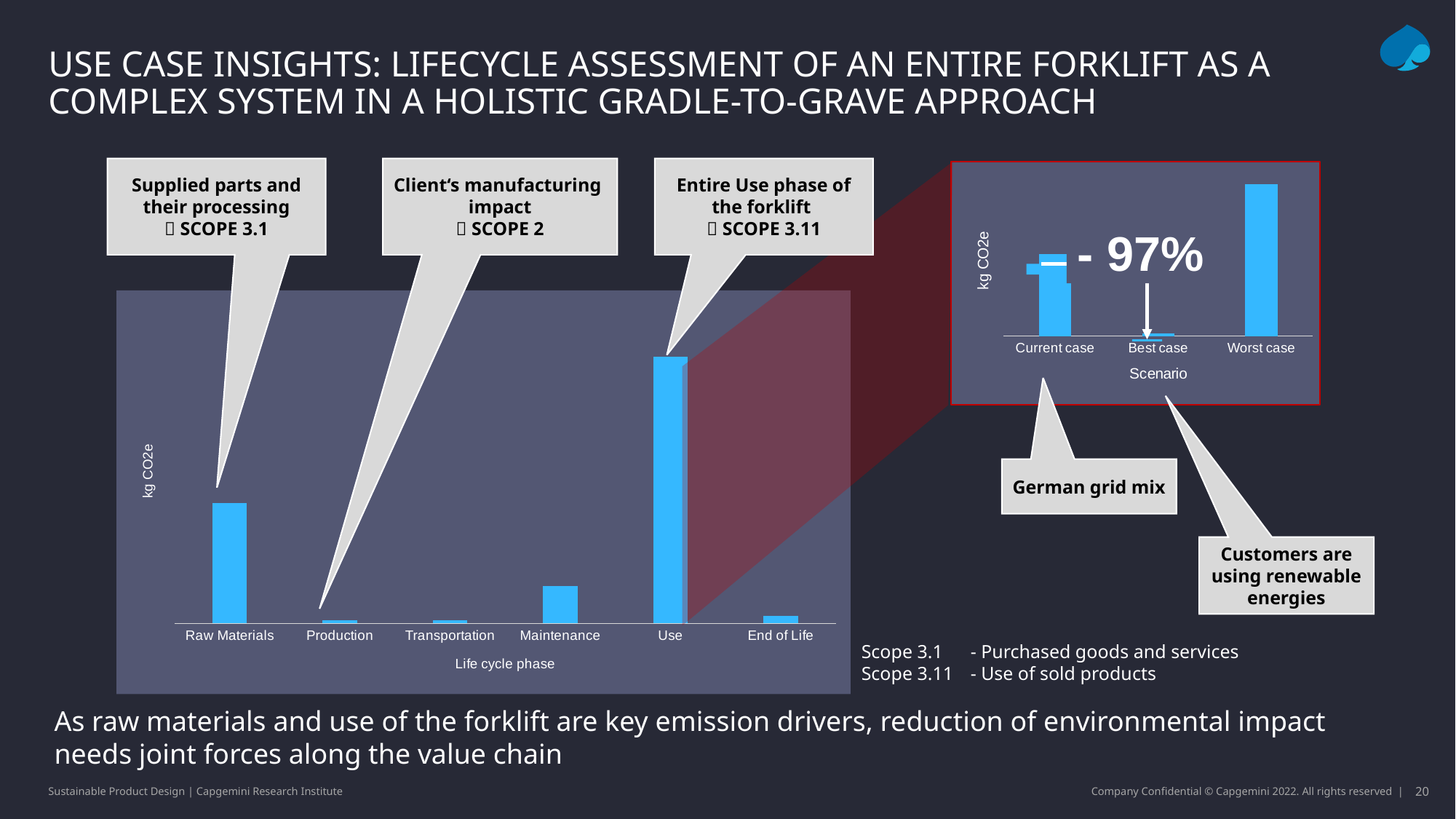
What is the y axis label of the left chart? kg CO2e How many scenarios are shown on the x axis of the right chart? 3 How many life cycle phases are shown on the x axis of the left chart? 6 What percentage change is annotated between the Current case and the Best case in the right chart? - 97% What kind of chart is the small chart on the right with the x axis labelled 'Scenario'? bar chart In the left chart, which life cycle phase has the highest kg CO2e value? Use What kind of chart is the large chart on the left with the x axis labelled 'Life cycle phase'? bar chart In the left chart, which has the larger kg CO2e value, Raw Materials or Maintenance? Raw Materials In the right chart, which has the larger kg CO2e value, Current case or Worst case? Worst case In the right chart, which scenario has the lowest kg CO2e value? Best case In the left chart, which has the larger kg CO2e value, Maintenance or End of Life? Maintenance In the right chart, which scenario has the highest kg CO2e value? Worst case